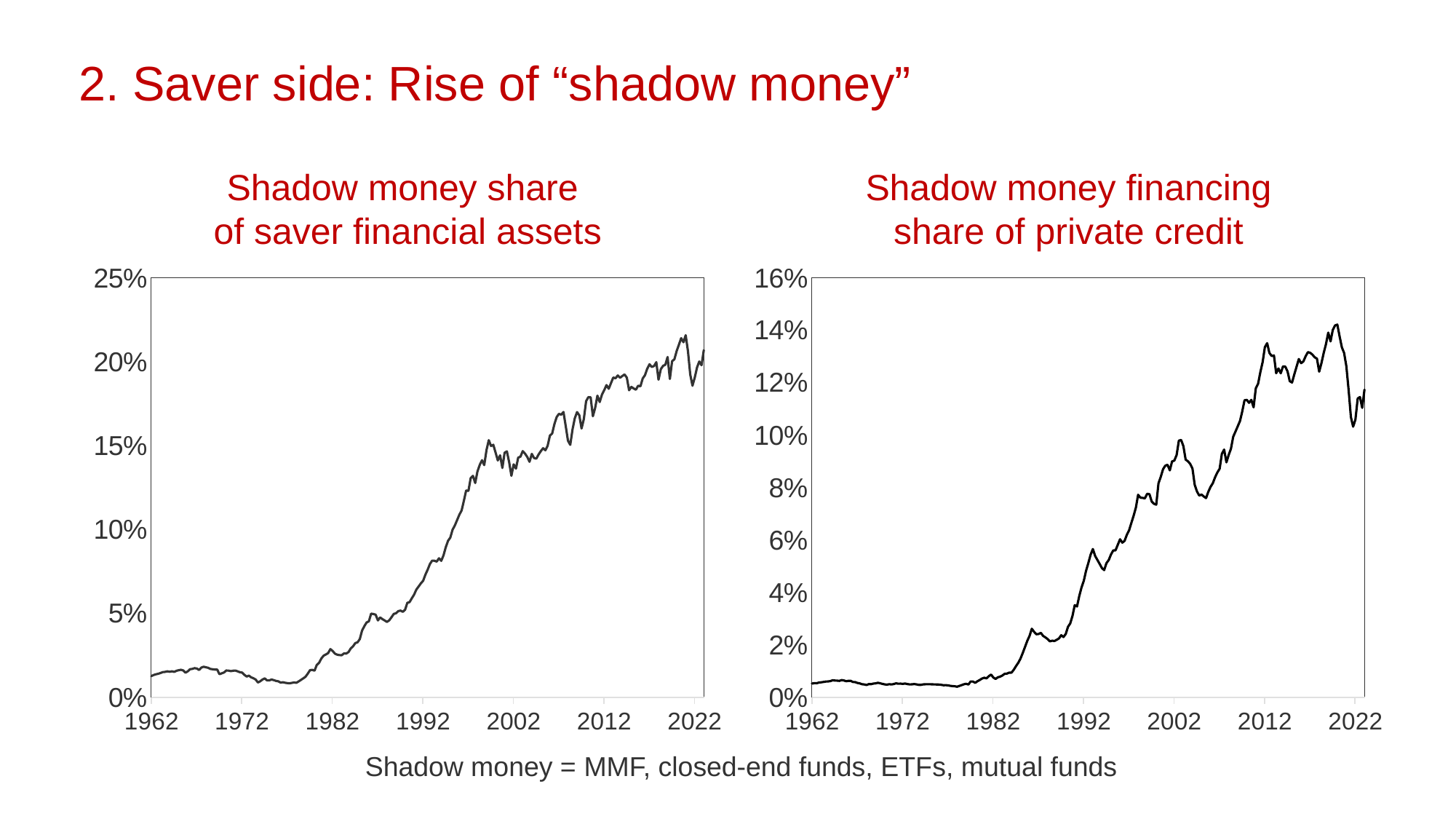
In the right chart, "Shadow money financing share of private credit", do the values generally rise or fall from 1962 to 2022? rise What is the title of the left chart on the slide? Shadow money share of saver financial assets In the right chart, "Shadow money financing share of private credit", is the value in 1962 greater or less than 2%? less In the left chart, "Shadow money share of saver financial assets", is the value in 2022 greater or less than 15%? greater What kind of chart is the right chart, "Shadow money financing share of private credit"? line chart In the left chart, "Shadow money share of saver financial assets", is the value in 1962 greater or less than 5%? less What is the highest value shown on the y axis of the right chart, "Shadow money financing share of private credit"? 16% What kind of chart is the left chart, "Shadow money share of saver financial assets"? line chart In the left chart, "Shadow money share of saver financial assets", do the values generally rise or fall from 1962 to 2022? rise